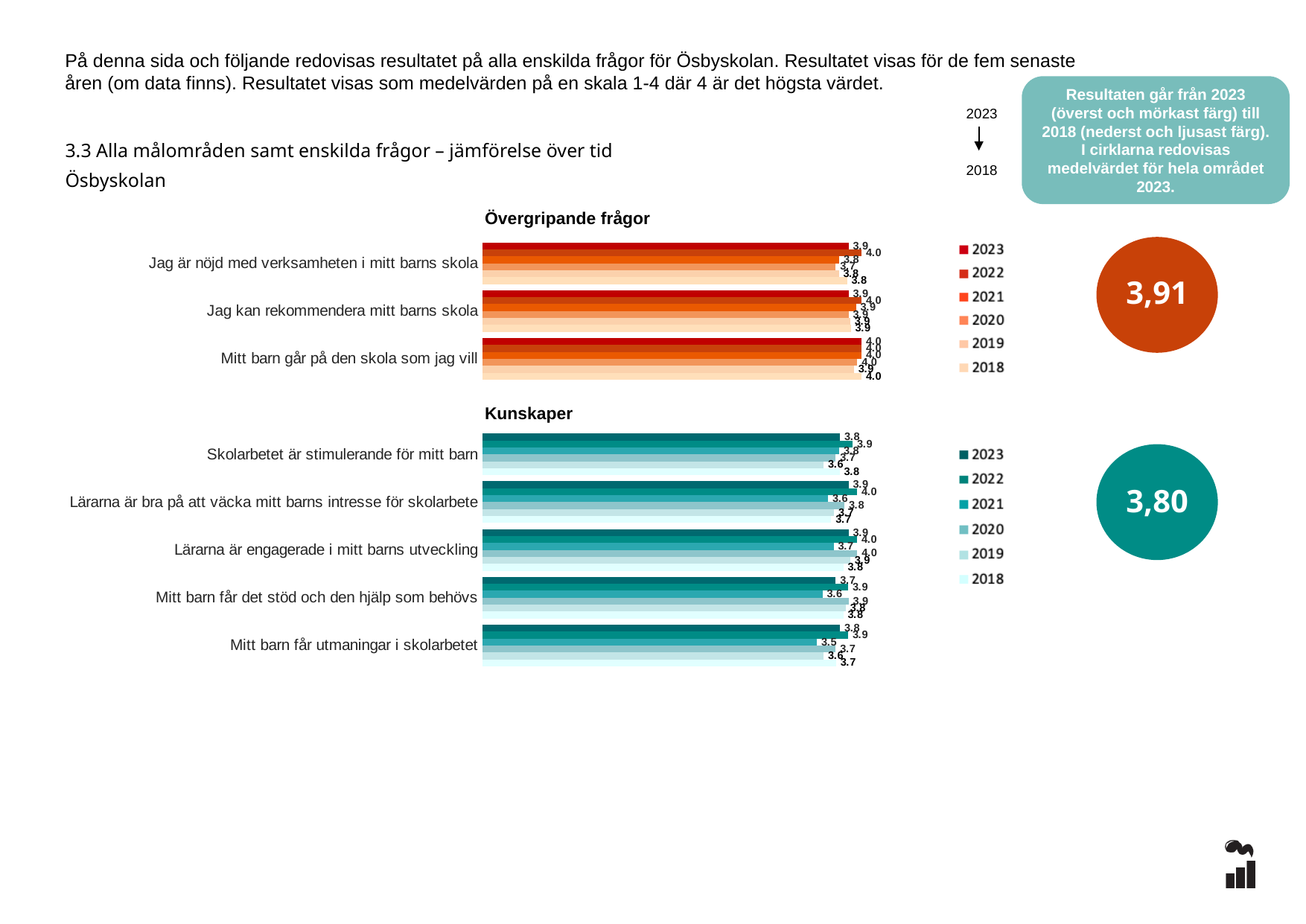
How many series does the legend of the Övergripande frågor chart list? 6 How many questions (categories) are shown in the Kunskaper chart? 5 In the Övergripande frågor chart, what is the 2018 value for "Jag kan rekommendera mitt barns skola"? 3.9 In the Kunskaper chart, what is the 2018 value for "Lärarna är bra på att väcka mitt barns intresse för skolarbete"? 3.7 In the Kunskaper chart, what is the 2023 value for "Mitt barn får det stöd och den hjälp som behövs"? 3.7 What overall mean value for 2023 is shown in the circle next to the Kunskaper chart? 3,80 What kind of chart is the Kunskaper chart? Bar chart In the Övergripande frågor chart, what is the 2023 value for "Jag är nöjd med verksamheten i mitt barns skola"? 3.9 In the Kunskaper chart, which is larger for "Mitt barn får utmaningar i skolarbetet": the 2023 value or the 2021 value? 2023 In the Kunskaper chart, what is the 2021 value for "Mitt barn får utmaningar i skolarbetet"? 3.5 In the Kunskaper chart, what is the difference between the 2023 value for "Lärarna är engagerade i mitt barns utveckling" and the 2023 value for "Mitt barn får det stöd och den hjälp som behövs"? 0.2 In the Kunskaper chart, which question has the lowest 2023 value? Mitt barn får det stöd och den hjälp som behövs